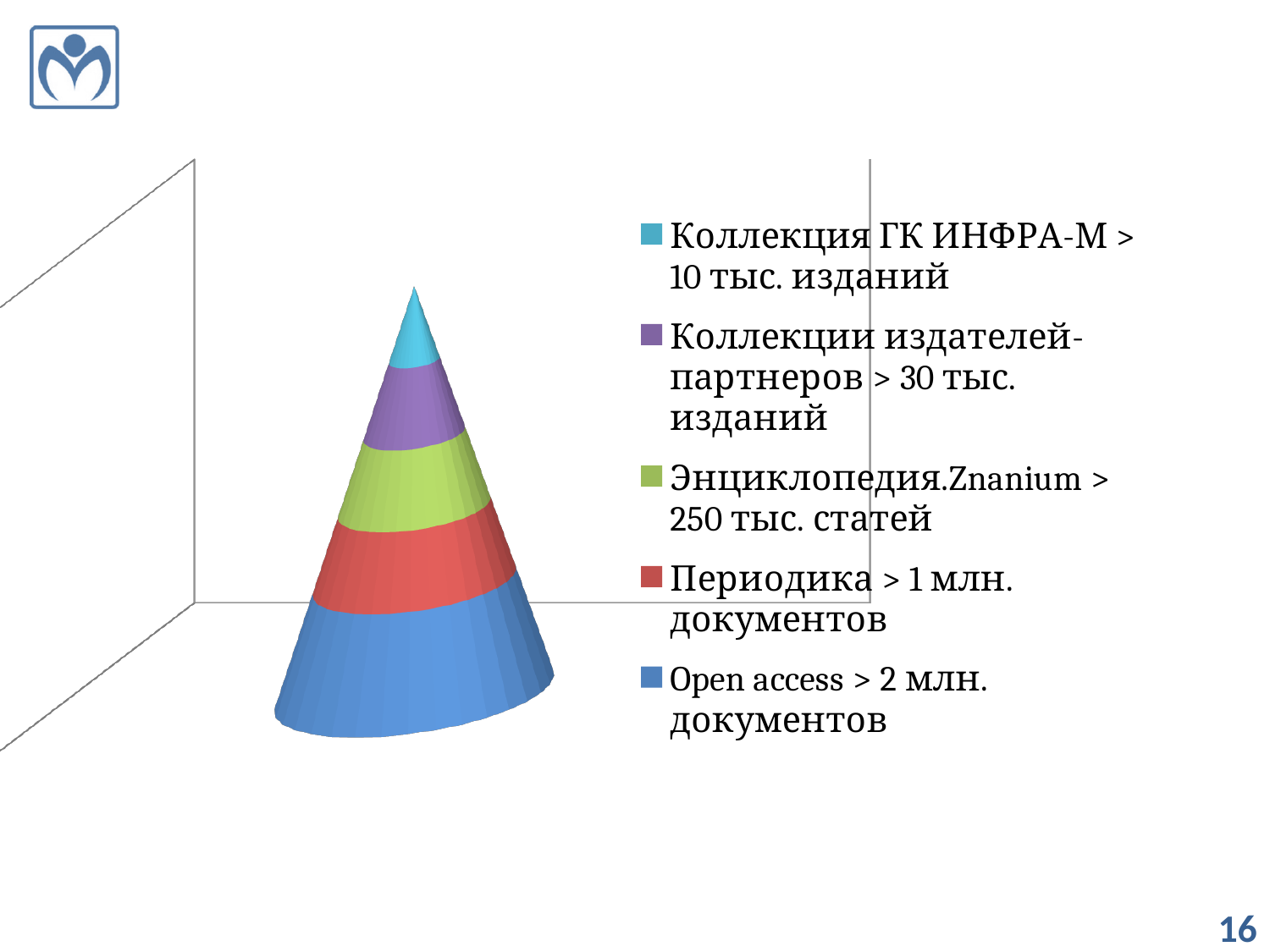
What kind of chart is shown on the slide? stacked cone chart How many segments make up the cone? 5 What colour represents "Периодика > 1 млн. документов" in the chart? red Which segment is larger, the red one (Периодика) or the green one (Энциклопедия.Znanium)? the red one (Периодика) Which legend entry is shown in blue? Open access > 2 млн. документов Which category occupies the largest segment of the cone? Open access > 2 млн. документов How many entries does the legend list? 5 Which category occupies the smallest segment of the cone? Коллекция ГК ИНФРА-М > 10 тыс. изданий